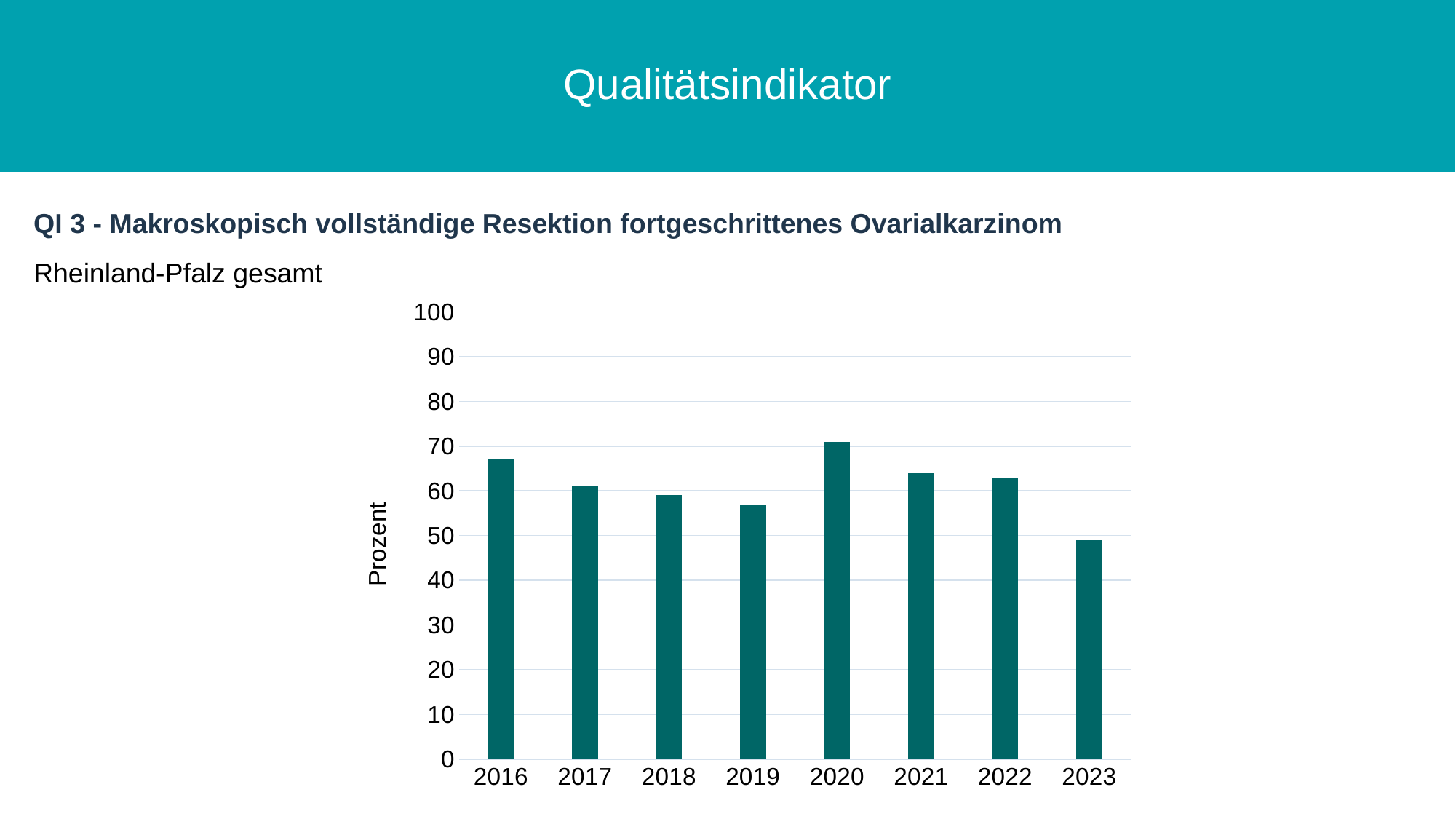
Is the value for 2019 greater or less than 60? less What kind of chart is shown on the slide? bar chart Which year has the lowest value in the chart? 2023 Is the value for 2023 greater or less than 60? less Is the value for 2020 greater or less than 60? greater Which year has the larger value, 2016 or 2017? 2016 How many years are shown on the x axis of the chart? 8 What is the label on the y axis of the chart? Prozent Which year has the larger value, 2019 or 2020? 2020 Which year has the highest value in the chart? 2020 Do the values rise or fall from 2016 to 2019? fall